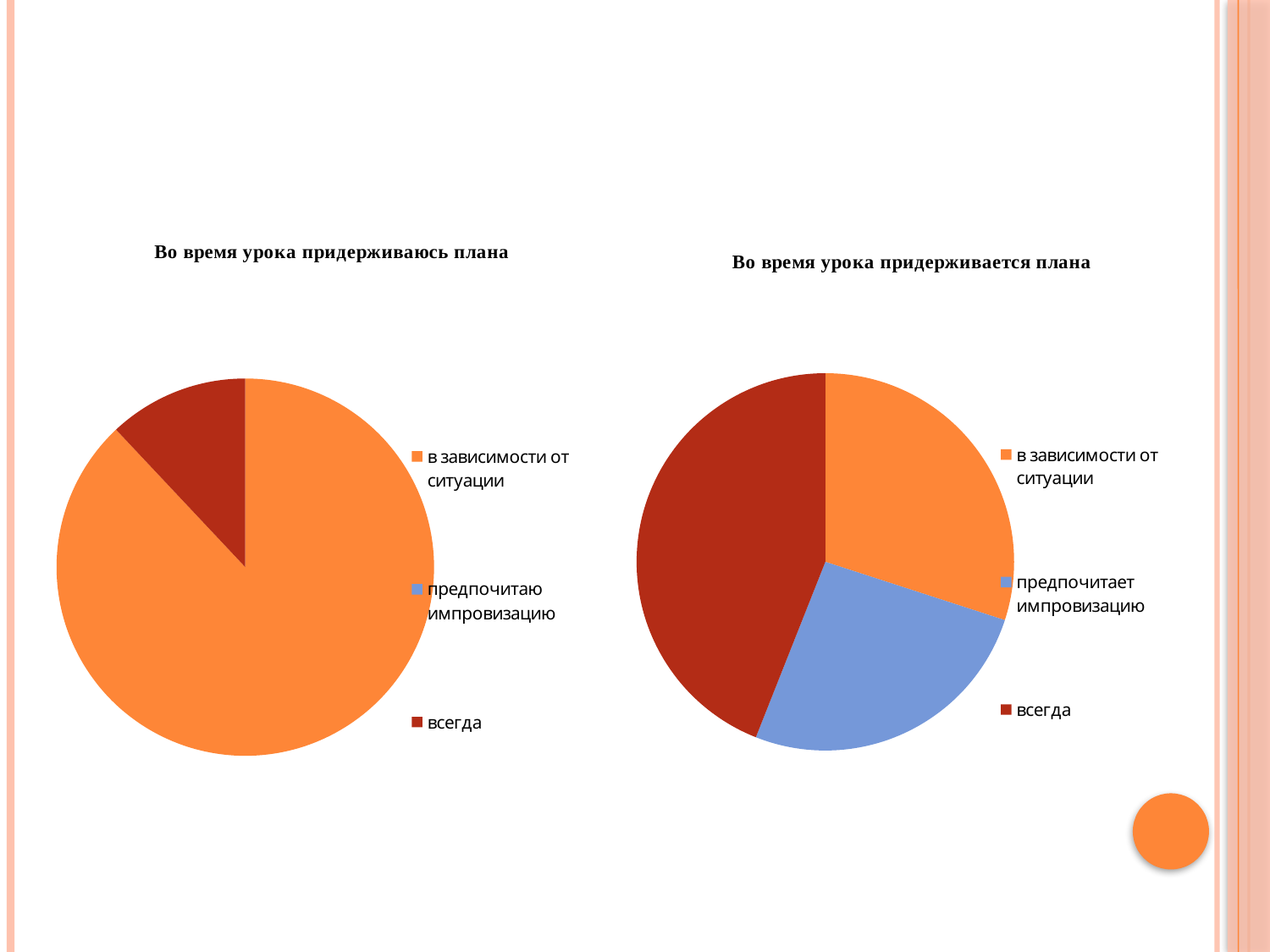
In the left chart "Во время урока придерживаюсь плана", which is larger: "в зависимости от ситуации" or "всегда"? в зависимости от ситуации How many entries does the legend of the left chart "Во время урока придерживаюсь плана" list? 3 What is the title of the left chart on the slide? Во время урока придерживаюсь плана In the right chart "Во время урока придерживается плана", which is larger: "всегда" or "в зависимости от ситуации"? всегда In the right chart "Во время урока придерживается плана", which category has the largest slice? всегда In the right chart "Во время урока придерживается плана", what colour is the slice for "предпочитает импровизацию"? blue How many entries does the legend of the right chart "Во время урока придерживается плана" list? 3 What kind of chart is the right chart titled "Во время урока придерживается плана"? pie chart In the right chart "Во время урока придерживается плана", which category has the smallest slice? предпочитает импровизацию In the right chart "Во время урока придерживается плана", which is larger: "в зависимости от ситуации" or "предпочитает импровизацию"? в зависимости от ситуации In the left chart "Во время урока придерживаюсь плана", which category has the largest slice? в зависимости от ситуации What kind of chart is the left chart titled "Во время урока придерживаюсь плана"? pie chart